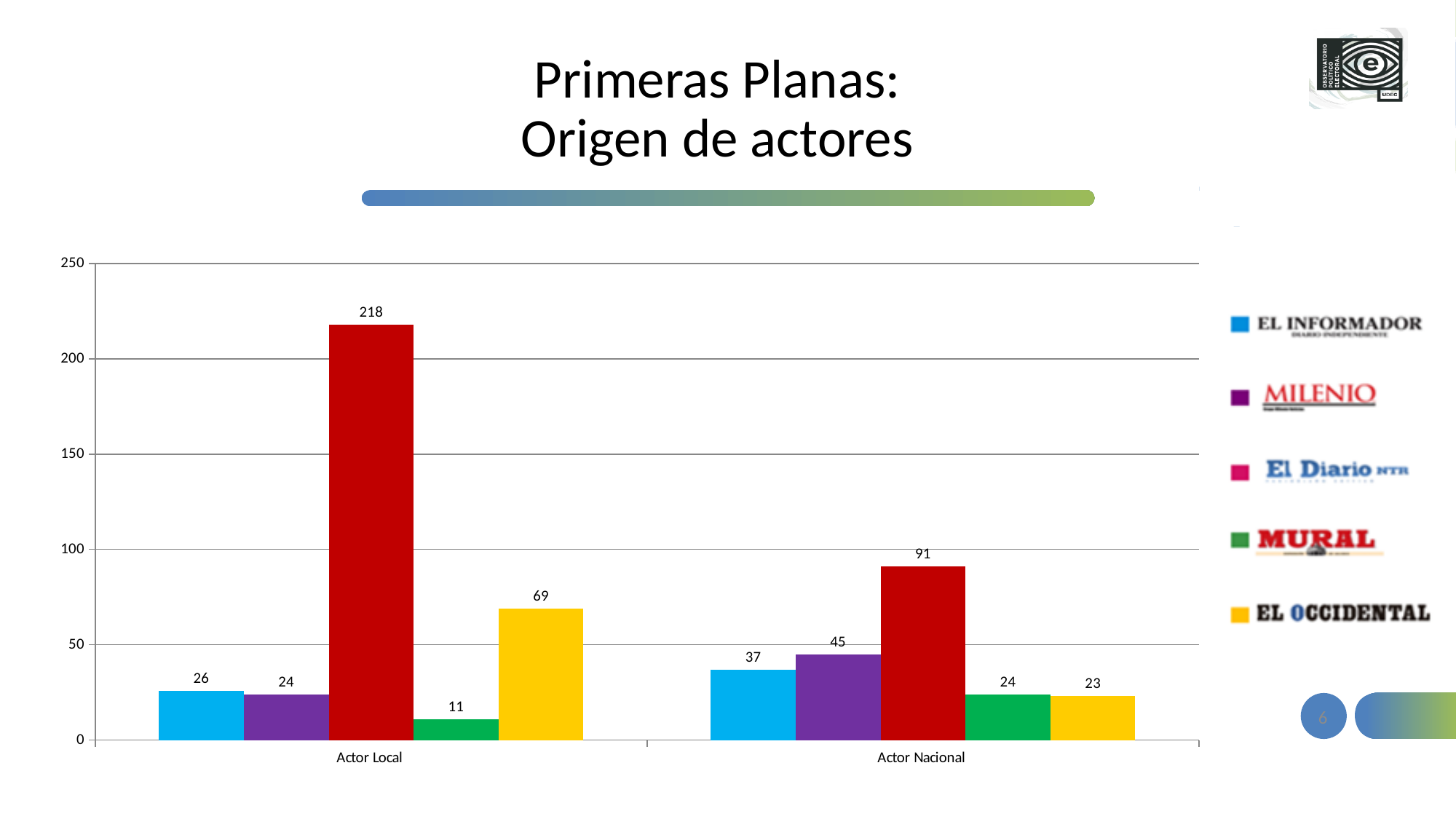
What is the value for Mural in the Actor Local category? 11 What is the value for El Occidental in the Actor Local category? 69 What is the value for El Diario NTR in the Actor Local category? 218 What kind of chart is shown on the slide? bar chart Which is larger: El Informador's value for Actor Local or for Actor Nacional? Actor Nacional How many categories are shown on the x axis? 2 What is the difference between El Diario NTR's values for Actor Local and Actor Nacional? 127 Which newspaper has the highest value in the Actor Nacional category? El Diario NTR What is the title of the slide? Primeras Planas: Origen de actores How many newspapers (series) does the legend list? 5 Which newspaper has the lowest value in the Actor Local category? Mural What is the value for Milenio in the Actor Nacional category? 45